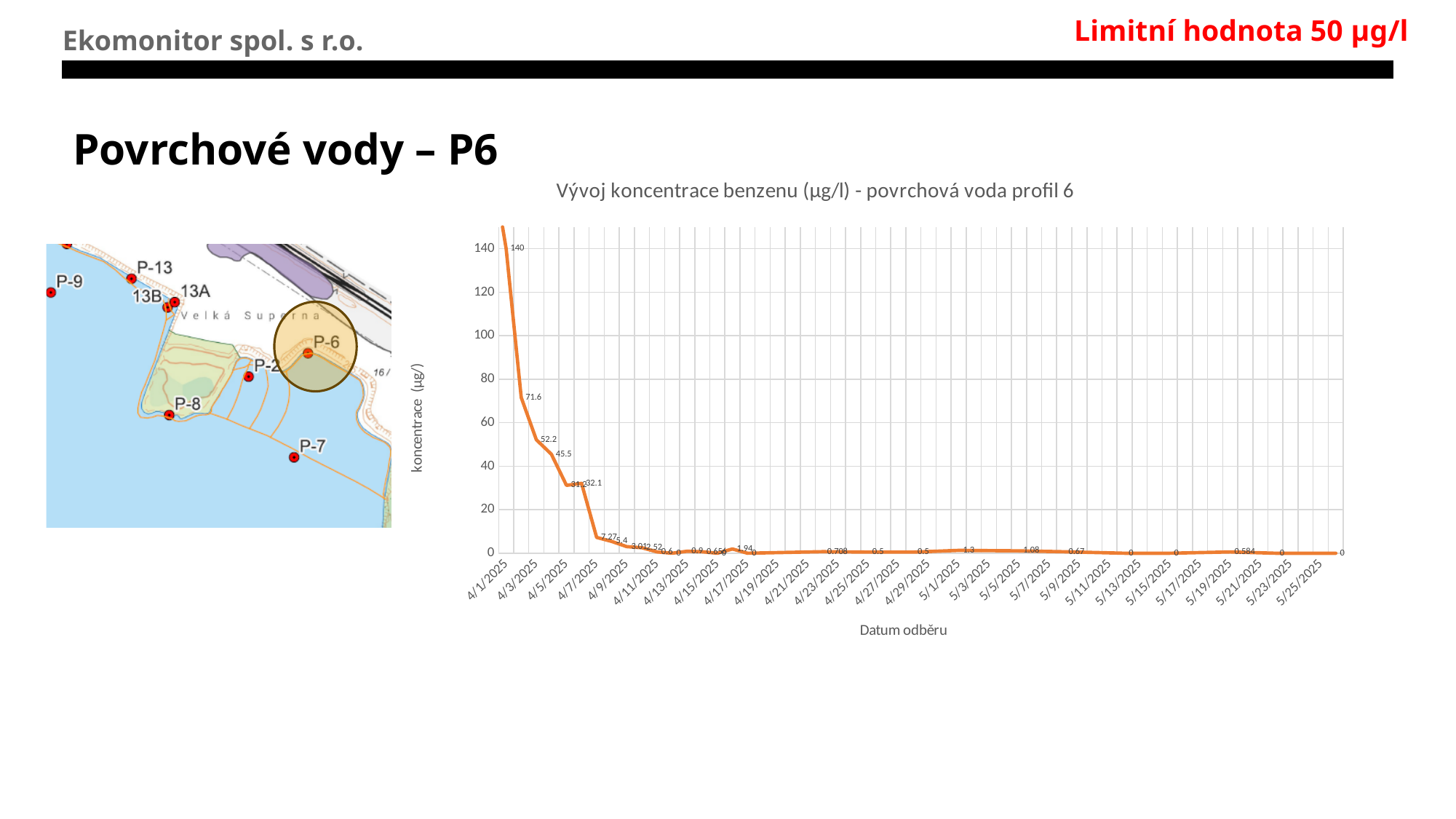
On which date does the chart reach its highest value? 4/1/2025 What is the benzene concentration value labelled at the first point, 4/1/2025? 140 What kind of chart is shown on the slide? line chart Is the value at 5/25/2025 greater or less than 20? less Do the values generally rise or fall along the x axis from 4/1/2025 to 5/25/2025? fall What is the highest value labelled on the chart? 140 What is the lowest value labelled on the chart? 0 Is the value at 4/1/2025 greater or less than 100? greater What is the difference between the first labelled value (140) and the second labelled value (71.6)? 68.4 Which is larger, the value at 4/1/2025 or the value at 5/25/2025? 4/1/2025 What is the label of the x axis of the chart? Datum odběru What is the title of the chart? Vývoj koncentrace benzenu (µg/l) - povrchová voda profil 6